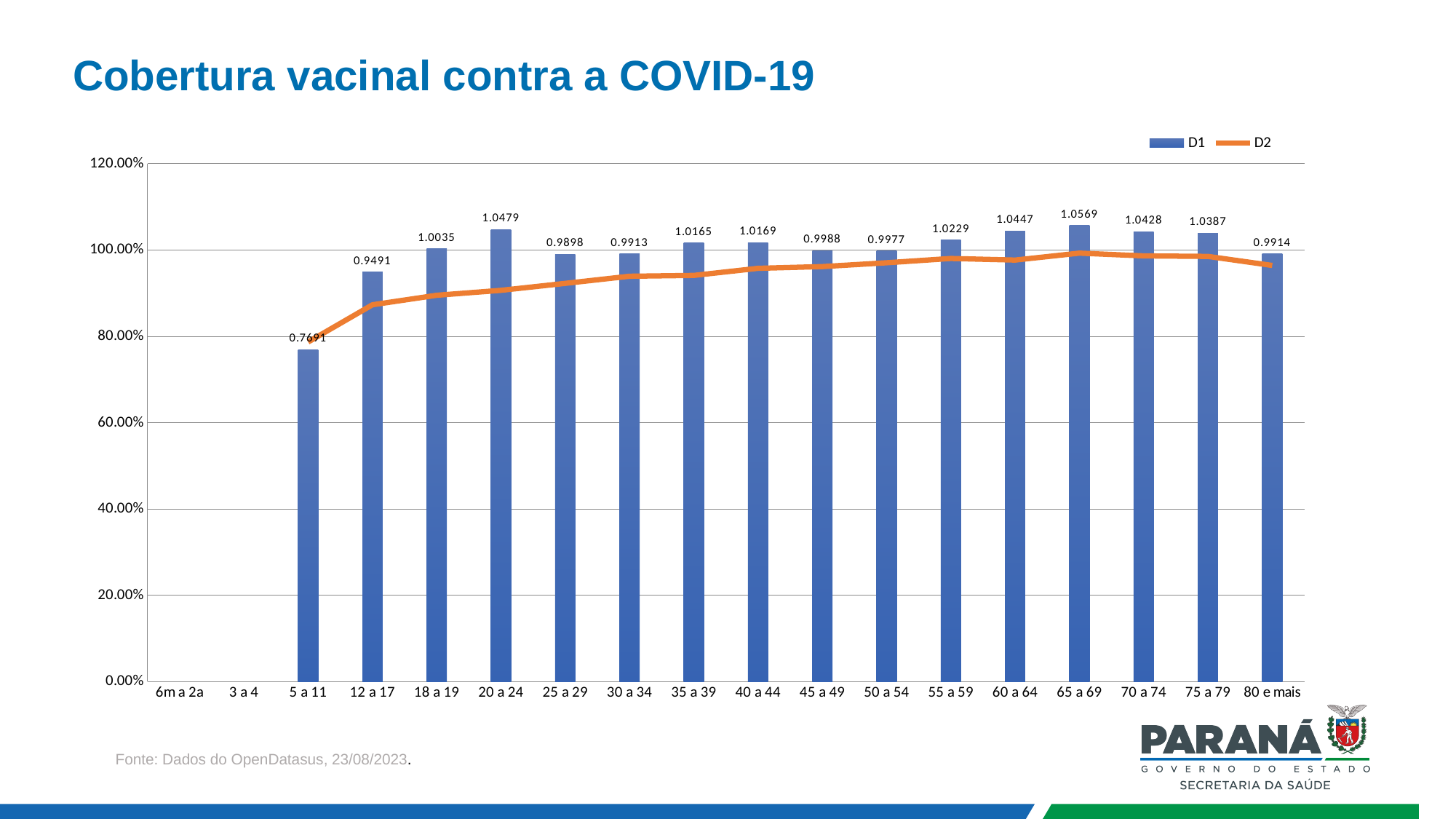
What is the D1 value for the 65 a 69 age group? 1.0569 Which has a larger D1 value, 18 a 19 or 12 a 17? 18 a 19 What is the title of the slide's chart? Cobertura vacinal contra a COVID-19 Is the D2 value for 12 a 17 greater or less than 80.00%? greater How many age group categories are shown on the x axis? 18 Is the D2 value for 80 e mais greater or less than 100.00%? less Among the age groups with a D1 bar, which has the lowest D1 value? 5 a 11 Which age group has the highest D1 value? 65 a 69 What is the difference between the D1 values for 20 a 24 and 5 a 11? 0.2788 What is the D1 value for the 80 e mais age group? 0.9914 What is the D1 value for the 5 a 11 age group? 0.7691 How many series does the legend list? 2